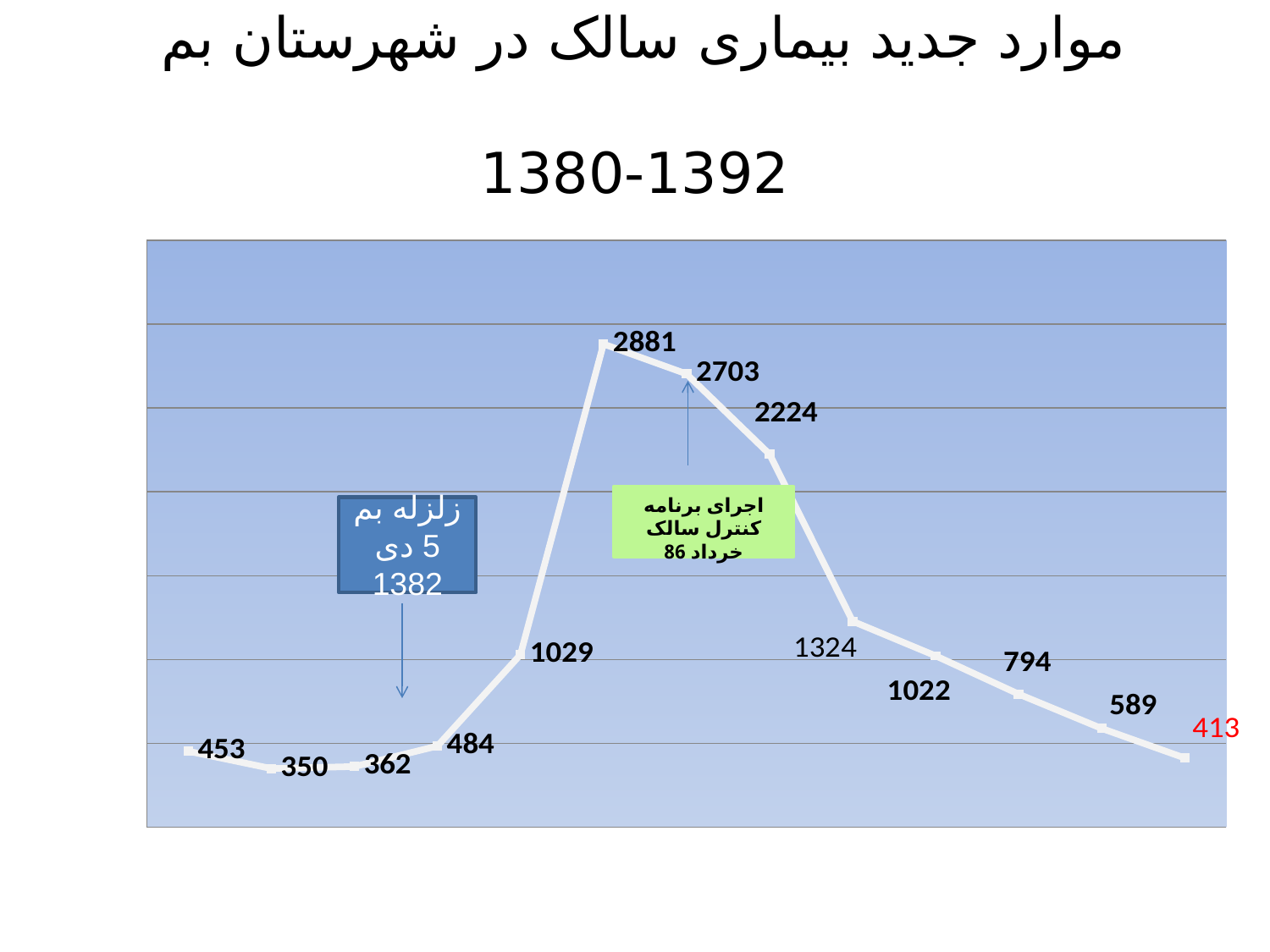
What is the value of the first (leftmost) point on the line? 453 What year range is given in the chart title? 1380-1392 What is the value of the point that the arrow from the green annotation box points to? 2703 Which is larger, the point labelled 1324 or the point labelled 1022? 1324 What kind of chart is shown on the slide? line chart What is the lowest value labelled on the chart? 350 After reaching the peak of 2881, do the values rise or fall along the rest of the line? fall What is the value of the last (rightmost) point on the line, shown in red? 413 How many data points are plotted on the line? 13 What is the difference between the peak value 2881 and the final value 413? 2468 What is the difference between the peak value 2881 and the next point 2703? 178 What is the highest value labelled on the chart? 2881